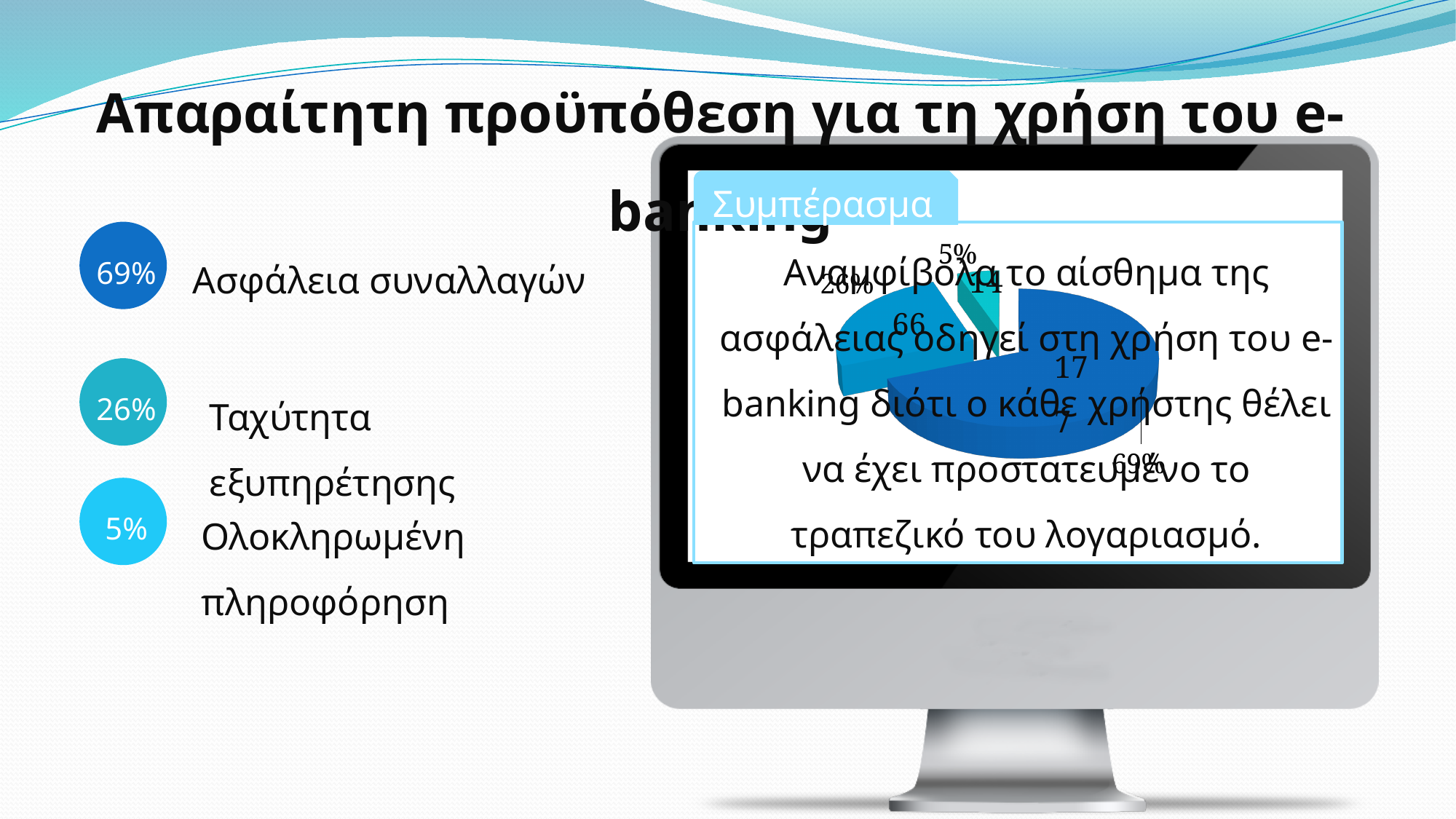
Which has the larger share of the pie, Ταχύτητα εξυπηρέτησης or Ολοκληρωμένη πληροφόρηση? Ταχύτητα εξυπηρέτησης What share of the pie corresponds to Ταχύτητα εξυπηρέτησης? 26% What share of the pie corresponds to Ολοκληρωμένη πληροφόρηση? 5% By how many percentage points does the 26% slice exceed the 5% slice? 21 By how many percentage points does the 69% slice exceed the 26% slice? 43 What share of the pie corresponds to Ασφάλεια συναλλαγών? 69% What kind of chart is shown on the monitor screen? pie chart What is the smallest percentage labelled on the pie chart? 5% How many slices does the pie chart have? 3 What do the three percentage labels on the pie chart add up to? 100% What is the largest percentage labelled on the pie chart? 69% What is the heading shown in the tab above the pie chart? Συμπέρασμα